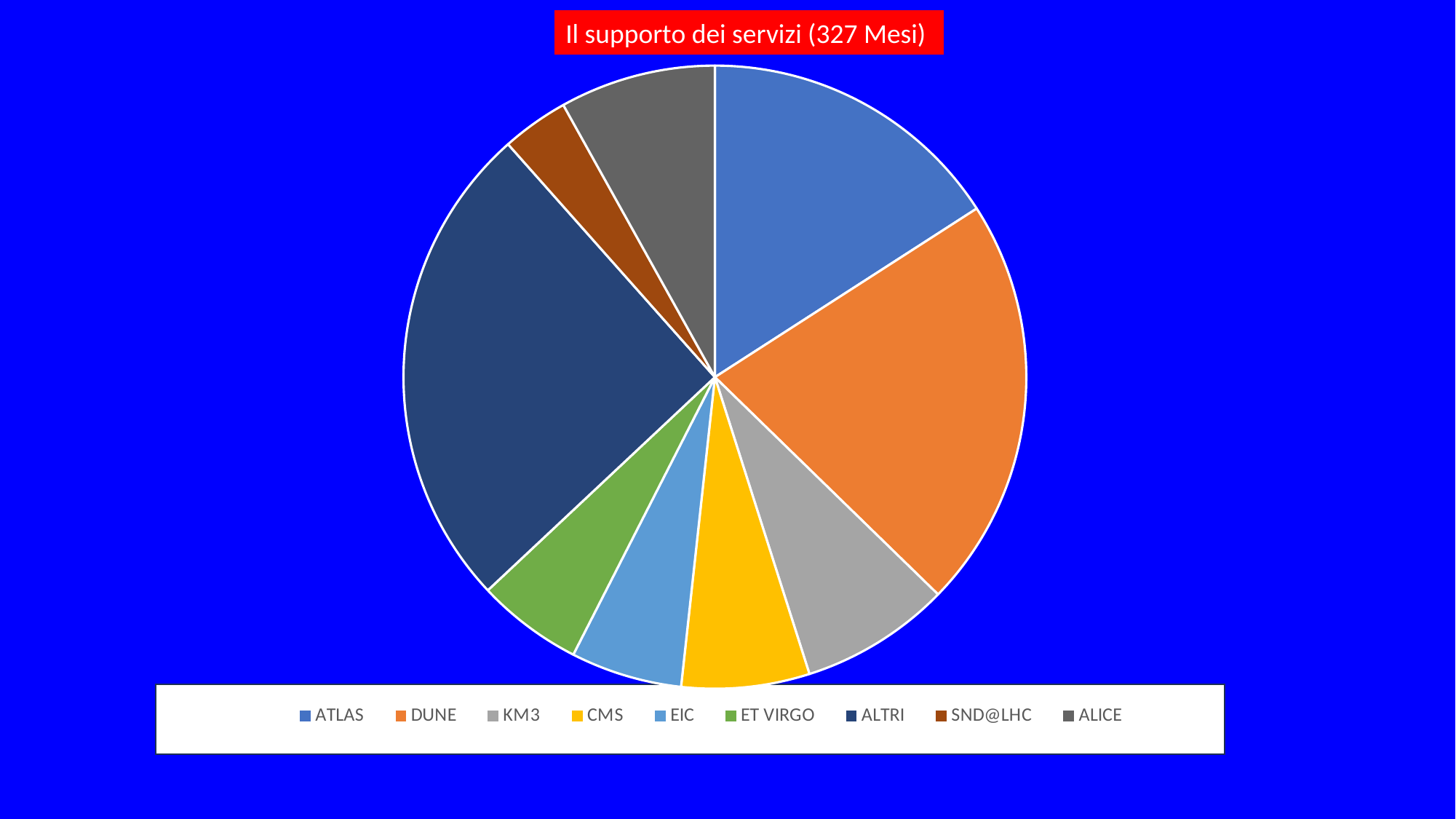
How many entries does the legend list? 9 Which category has the smallest slice of the pie? SND@LHC What kind of chart is shown on the slide? pie chart Which slice is larger, ALICE or SND@LHC? ALICE Which category has the largest slice of the pie? ALTRI Which slice is larger, DUNE or ATLAS? DUNE Which slice is larger, ATLAS or KM3? ATLAS What is the title of the chart? Il supporto dei servizi (327 Mesi) How many slices does the pie chart have? 9 Which category is shown in orange in the legend? DUNE